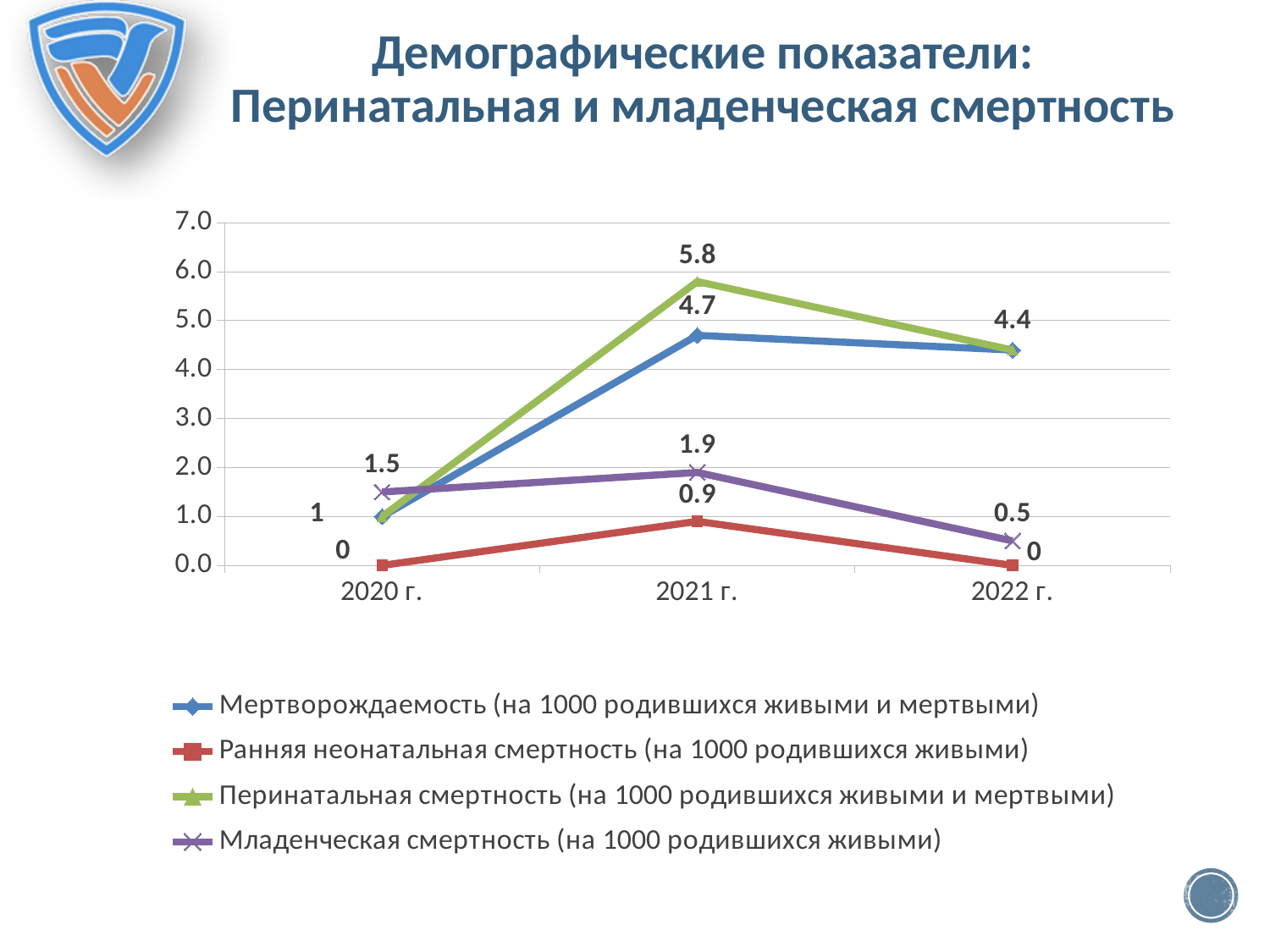
What is the value of Ранняя неонатальная смертность in 2021 г.? 0.9 What is the value of Младенческая смертность in 2022 г.? 0.5 Does Младенческая смертность rise or fall from 2021 г. to 2022 г.? fall Which year has the larger value for Младенческая смертность, 2020 г. or 2022 г.? 2020 г. What is the value of Младенческая смертность in 2020 г.? 1.5 What is the difference between Перинатальная смертность and Мертворождаемость in 2021 г.? 1.1 How many years are shown on the x axis? 3 How many series does the legend list? 4 What kind of chart is shown on the slide? line chart What is the value of Мертворождаемость in 2021 г.? 4.7 What is the value of Перинатальная смертность in 2021 г.? 5.8 In which year is Перинатальная смертность highest? 2021 г.